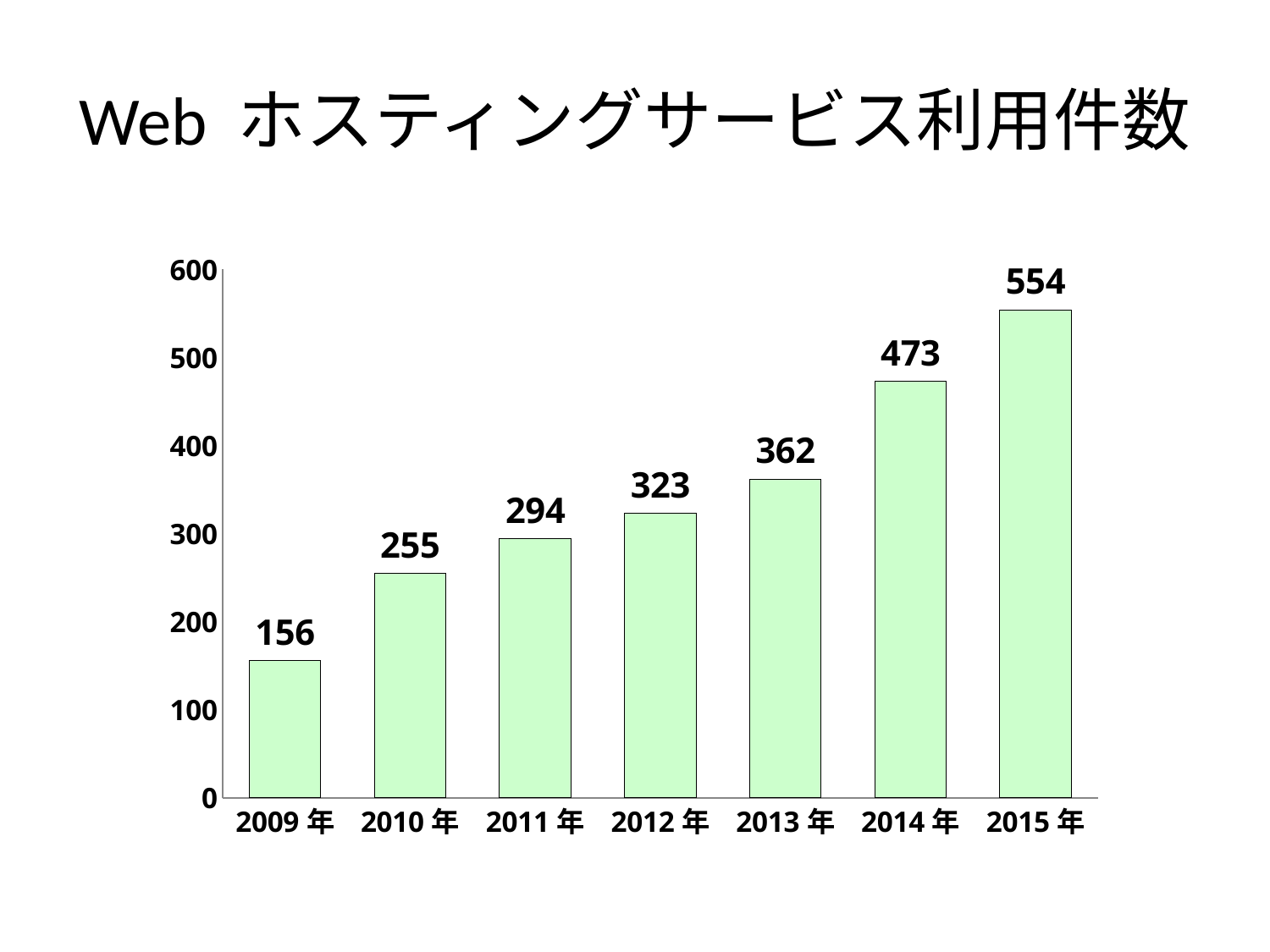
What is the value for 2009年? 156 What is the difference between the values for 2015年 and 2014年? 81 What is the difference between the values for 2010年 and 2009年? 99 Which year has the lowest value? 2009年 Which year has the highest value? 2015年 What is the value for 2014年? 473 How many years are shown on the x axis? 7 Is the value for 2013年 greater or less than 400? less Which is larger, the value for 2011年 or the value for 2013年? 2013年 What is the value for 2012年? 323 What kind of chart is shown on the slide? bar chart Do the values rise or fall from 2009年 to 2015年? rise